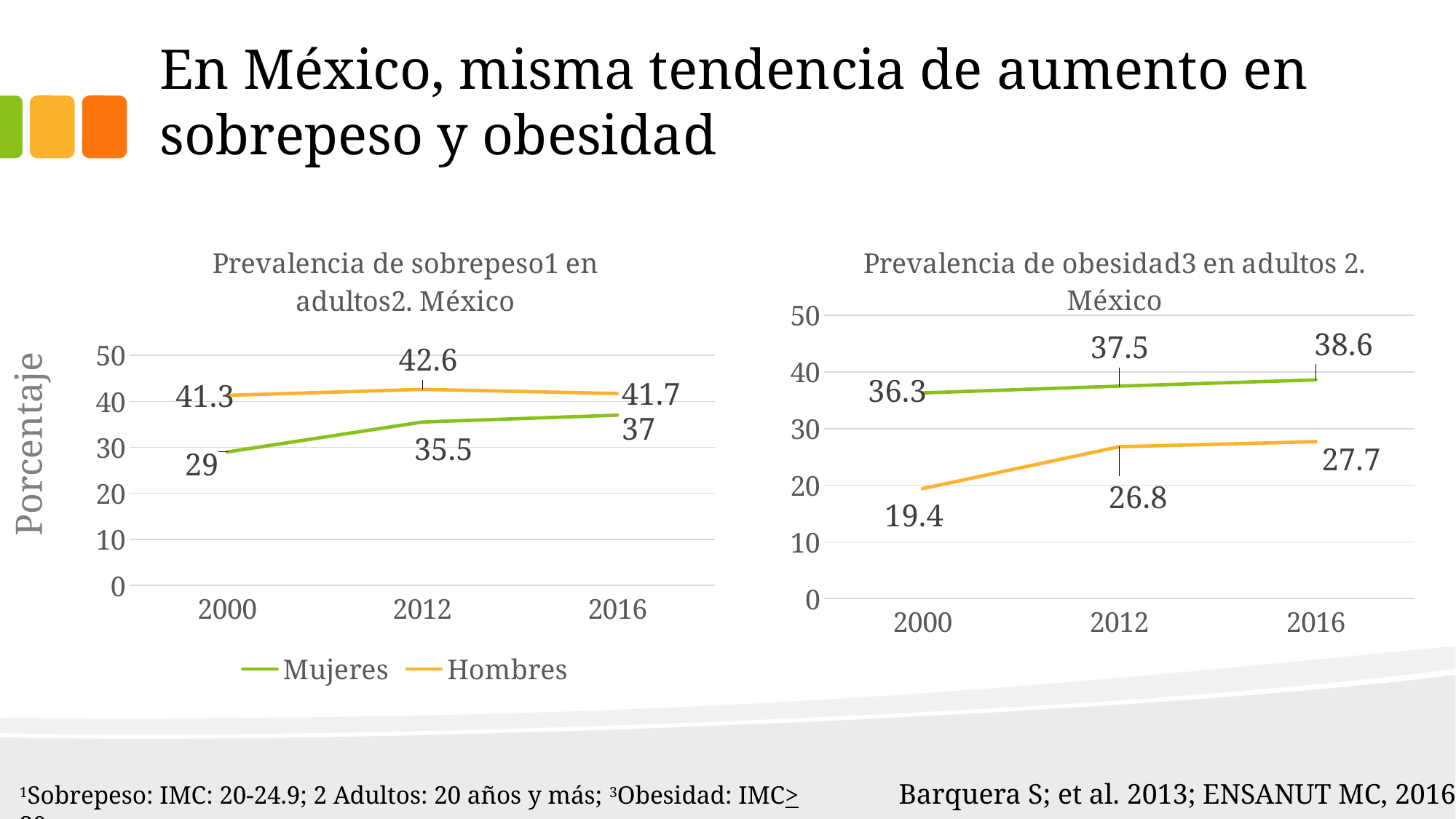
How many series does the legend of the left chart list? 2 In the left chart (Prevalencia de sobrepeso), does the Mujeres line rise or fall from 2000 to 2016? Rise In the left chart (Prevalencia de sobrepeso), what is the value for Mujeres in 2000? 29 In the right chart (Prevalencia de obesidad), what is the value of the green line in 2016? 38.6 In the right chart (Prevalencia de obesidad), in which year is the orange line lowest? 2000 In the right chart (Prevalencia de obesidad), by how much did the orange line increase from 2000 to 2016? 8.3 In the left chart (Prevalencia de sobrepeso), what is the difference between the Hombres and Mujeres values in 2000? 12.3 In the right chart (Prevalencia de obesidad), what is the value of the orange line in 2000? 19.4 In the left chart (Prevalencia de sobrepeso), which series has the larger value in 2016, Mujeres or Hombres? Hombres In the left chart (Prevalencia de sobrepeso), what is the value for Hombres in 2012? 42.6 In the left chart (Prevalencia de sobrepeso), in which year is the Mujeres value highest? 2016 What type of chart is the right chart (Prevalencia de obesidad)? Line chart